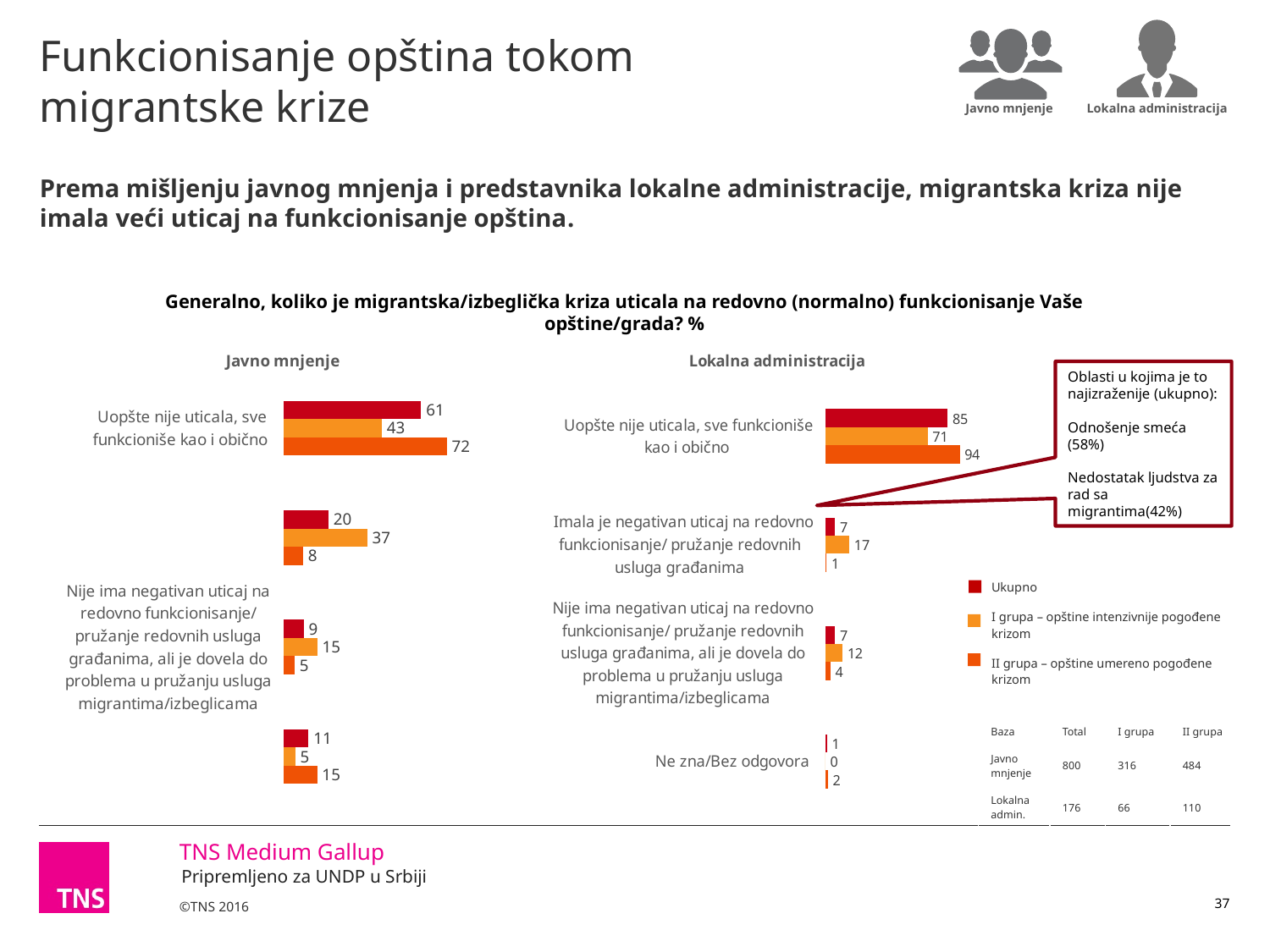
How many series does the legend list for the charts? 3 In the Lokalna administracija chart, what is the I grupa value for "Imala je negativan uticaj na redovno funkcionisanje/ pružanje redovnih usluga građanima"? 17 What type of chart is the Lokalna administracija chart? Bar chart In the Javno mnjenje chart, what is the difference between the II grupa and I grupa values for "Uopšte nije uticala, sve funkcioniše kao i obično"? 29 In the Lokalna administracija chart, what is the Ukupno value for "Uopšte nije uticala, sve funkcioniše kao i obično"? 85 In the Lokalna administracija chart, which is larger for "Uopšte nije uticala, sve funkcioniše kao i obično": the I grupa value or the II grupa value? II grupa In the Lokalna administracija chart, which category has the highest Ukupno value? Uopšte nije uticala, sve funkcioniše kao i obično In the Lokalna administracija chart, which category has the lowest Ukupno value? Ne zna/Bez odgovora In the Lokalna administracija chart, what is the II grupa value for "Uopšte nije uticala, sve funkcioniše kao i obično"? 94 In the Javno mnjenje chart, what is the Ukupno value for "Uopšte nije uticala, sve funkcioniše kao i obično"? 61 In the Javno mnjenje chart, what is the I grupa value for "Uopšte nije uticala, sve funkcioniše kao i obično"? 43 In the Lokalna administracija chart, what is the I grupa value for "Ne zna/Bez odgovora"? 0